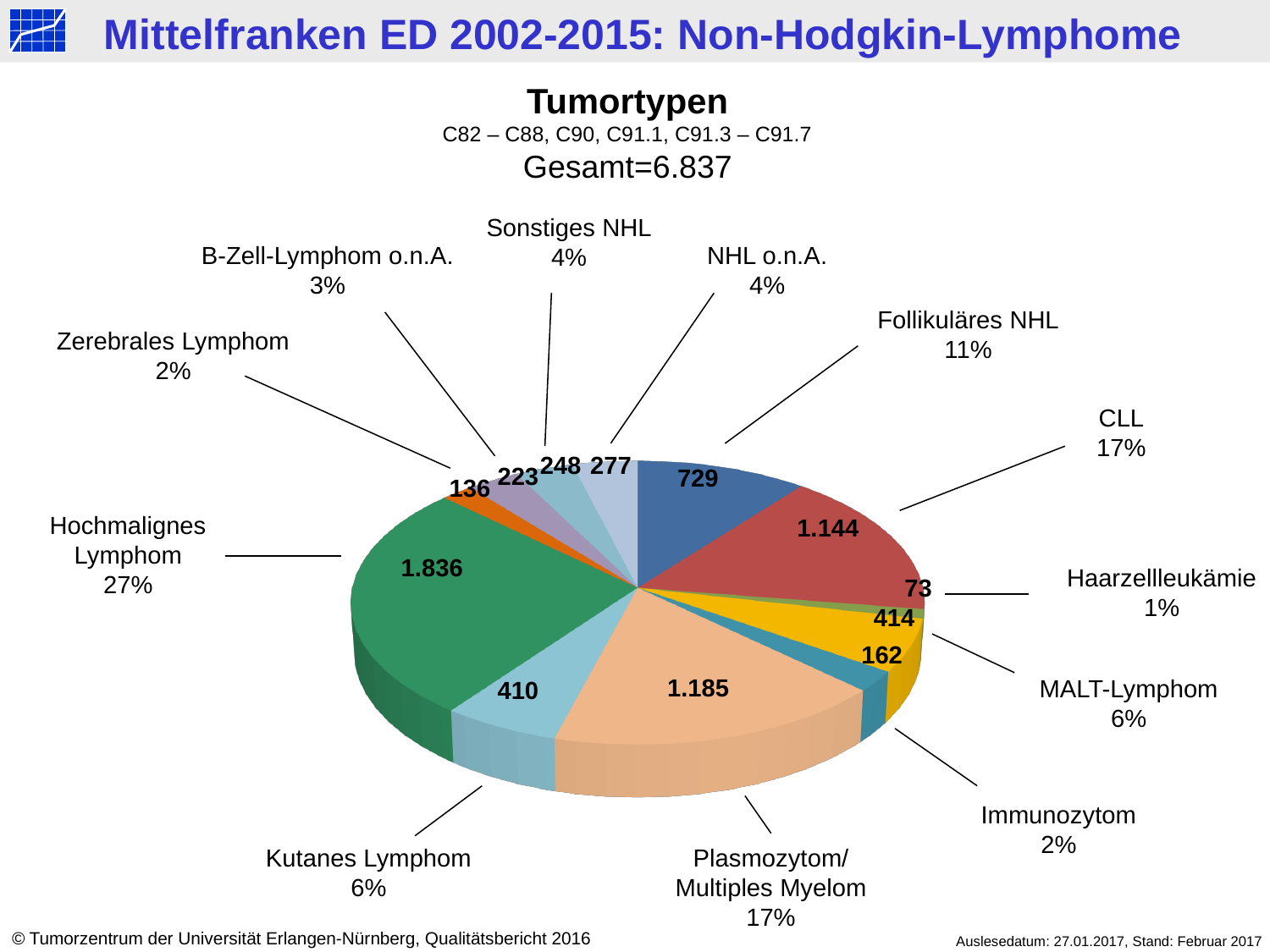
What total number of cases (Gesamt) is stated above the chart? 6.837 Which tumour type has the smallest slice? Haarzellleukämie What is the value for CLL? 1.144 What type of chart is shown on the slide? pie chart What is the difference between the values for Plasmozytom/Multiples Myelom and CLL? 41 How many tumour types are shown in the pie chart? 12 What is the value for MALT-Lymphom? 414 What percentage share does Follikuläres NHL have? 11% Which tumour type has the largest slice? Hochmalignes Lymphom What share of the pie does Plasmozytom/Multiples Myelom represent? 17% Which is larger, the value for Kutanes Lymphom or the value for MALT-Lymphom? MALT-Lymphom How many cases are shown for Hochmalignes Lymphom? 1.836